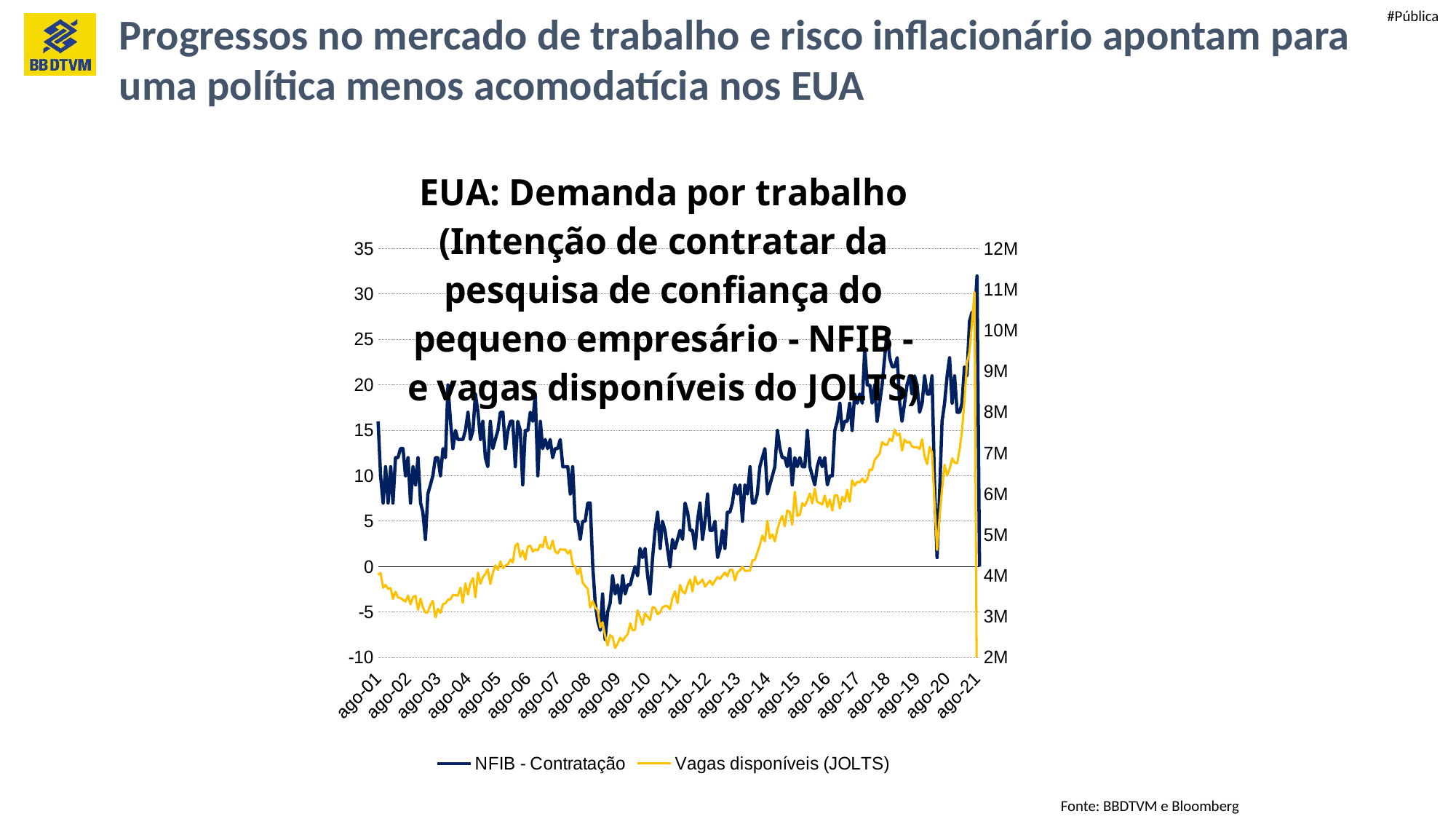
Is the value of NFIB - Contratação at ago-06 greater or less than 10? greater What kind of chart is shown on the slide? line chart Is the value of Vagas disponíveis (JOLTS) at ago-09 greater or less than 3M? less Is the value of NFIB - Contratação at ago-09 greater or less than 0? less Around which x-axis label does the Vagas disponíveis (JOLTS) series reach its highest point? ago-21 Which series is drawn in yellow? Vagas disponíveis (JOLTS) How many series does the legend list? 2 Does the Vagas disponíveis (JOLTS) series rise or fall between ago-09 and ago-18? rise How many date labels are shown on the x axis? 21 What are the two series named in the legend? NFIB - Contratação and Vagas disponíveis (JOLTS)